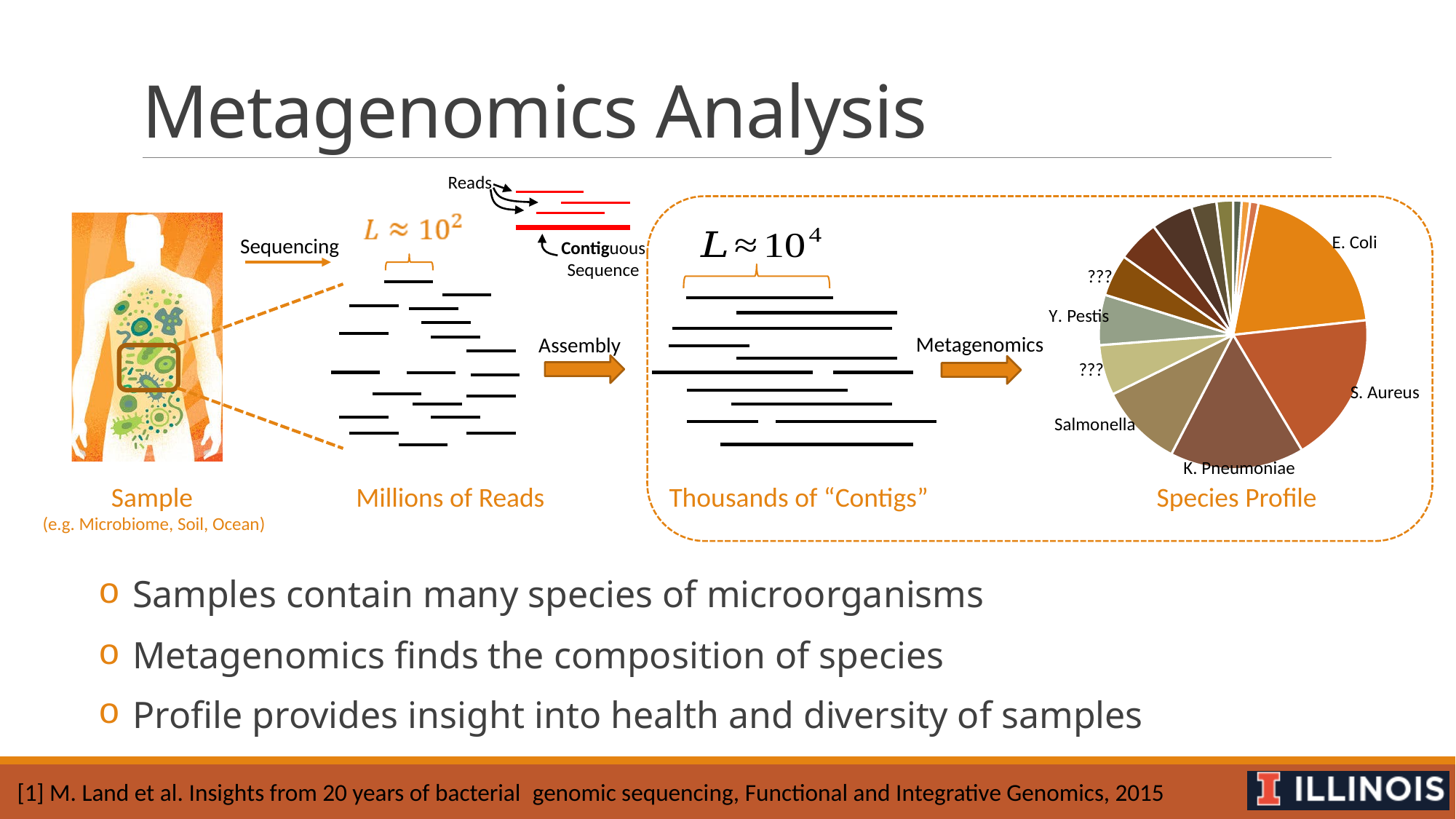
In the Species Profile pie chart, which slice is larger, E. Coli or Salmonella? E. Coli In the Species Profile pie chart, which slice is larger, K. Pneumoniae or Y. Pestis? K. Pneumoniae Which label appears twice on the Species Profile pie chart? ??? What kind of chart is the Species Profile chart? pie chart How many named species (excluding '???') are labeled on the Species Profile pie chart? 5 In the Species Profile pie chart, which slice is larger, S. Aureus or Salmonella? S. Aureus What is the title shown under the pie chart on the slide? Species Profile In the Species Profile pie chart, which labeled species has the largest slice? E. Coli